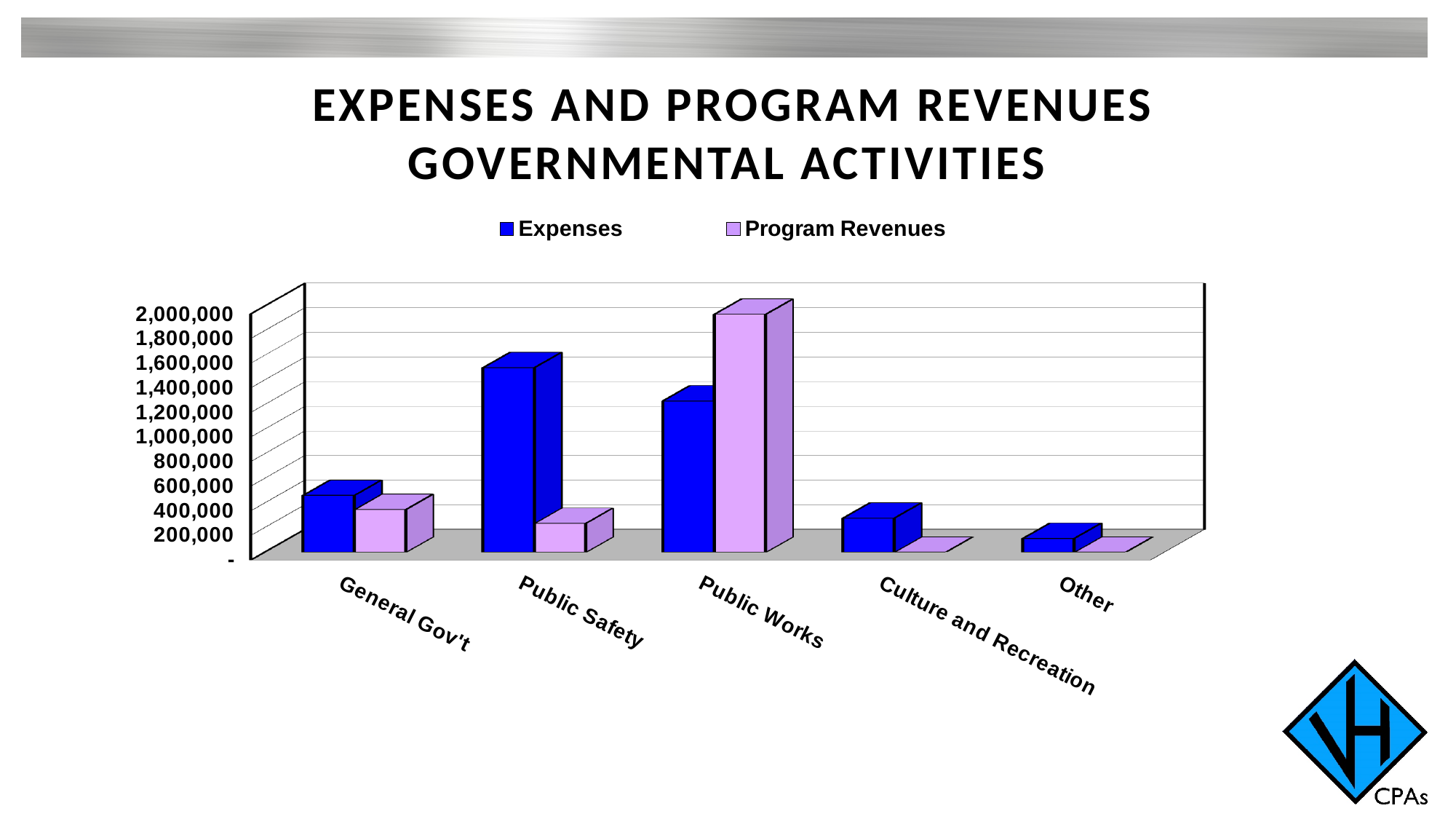
How many categories are shown on the x axis? 5 Which category has the lowest Expenses bar? Other What kind of chart is shown on the slide? Bar chart Is the Expenses value for Public Safety greater or less than 1,000,000? greater For Public Works, which is larger: Expenses or Program Revenues? Program Revenues How many series does the legend list? 2 Is the Program Revenues value for Public Works greater or less than 1,600,000? greater What is the title of the chart? Expenses and Program Revenues Governmental Activities Is the Expenses value for Culture and Recreation greater or less than 600,000? less Which category has the highest Expenses bar? Public Safety For Public Safety, which is larger: Expenses or Program Revenues? Expenses Which category has the highest Program Revenues bar? Public Works